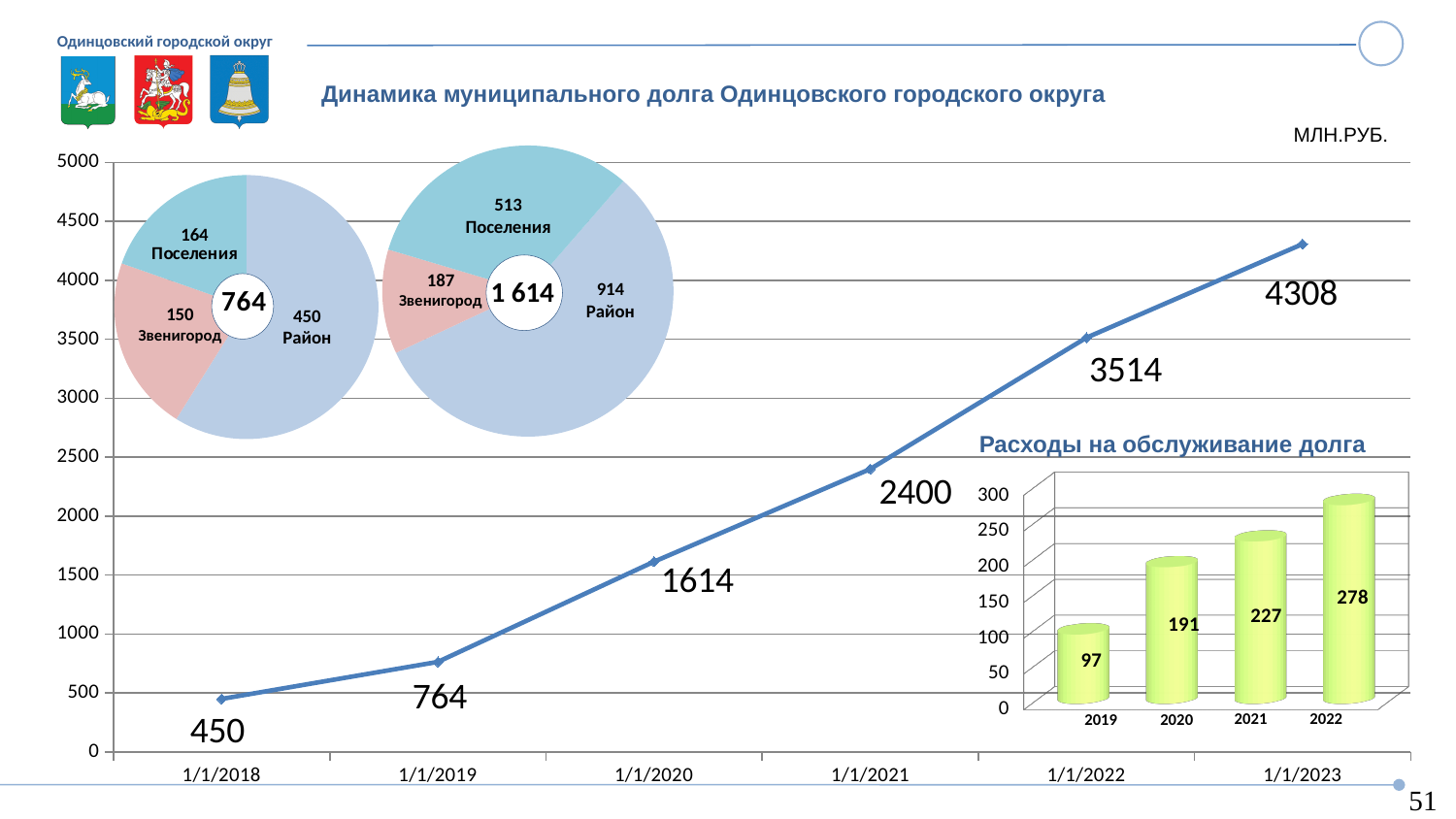
On the line chart 'Динамика муниципального долга Одинцовского городского округа', what is the value for 1/1/2021? 2400 On the bar chart 'Расходы на обслуживание долга', what is the difference between the values for 2020 and 2019? 94 On the line chart 'Динамика муниципального долга Одинцовского городского округа', what is the difference between the values for 1/1/2023 and 1/1/2022? 794 On the bar chart 'Расходы на обслуживание долга', what is the value for 2021? 227 How many data points are plotted on the line chart 'Динамика муниципального долга Одинцовского городского округа'? 6 In the pie chart with total 764, which is larger: Поселения or Звенигород? Поселения In the pie chart with total 1 614, what is the value for Район? 914 What kind of chart is 'Расходы на обслуживание долга'? bar chart On the line chart 'Динамика муниципального долга Одинцовского городского округа', which date has the lowest value? 1/1/2018 On the bar chart 'Расходы на обслуживание долга', which year has the highest value? 2022 On the line chart 'Динамика муниципального долга Одинцовского городского округа', do the values rise or fall from 1/1/2018 to 1/1/2023? rise On the line chart 'Динамика муниципального долга Одинцовского городского округа', what is the value for 1/1/2023? 4308